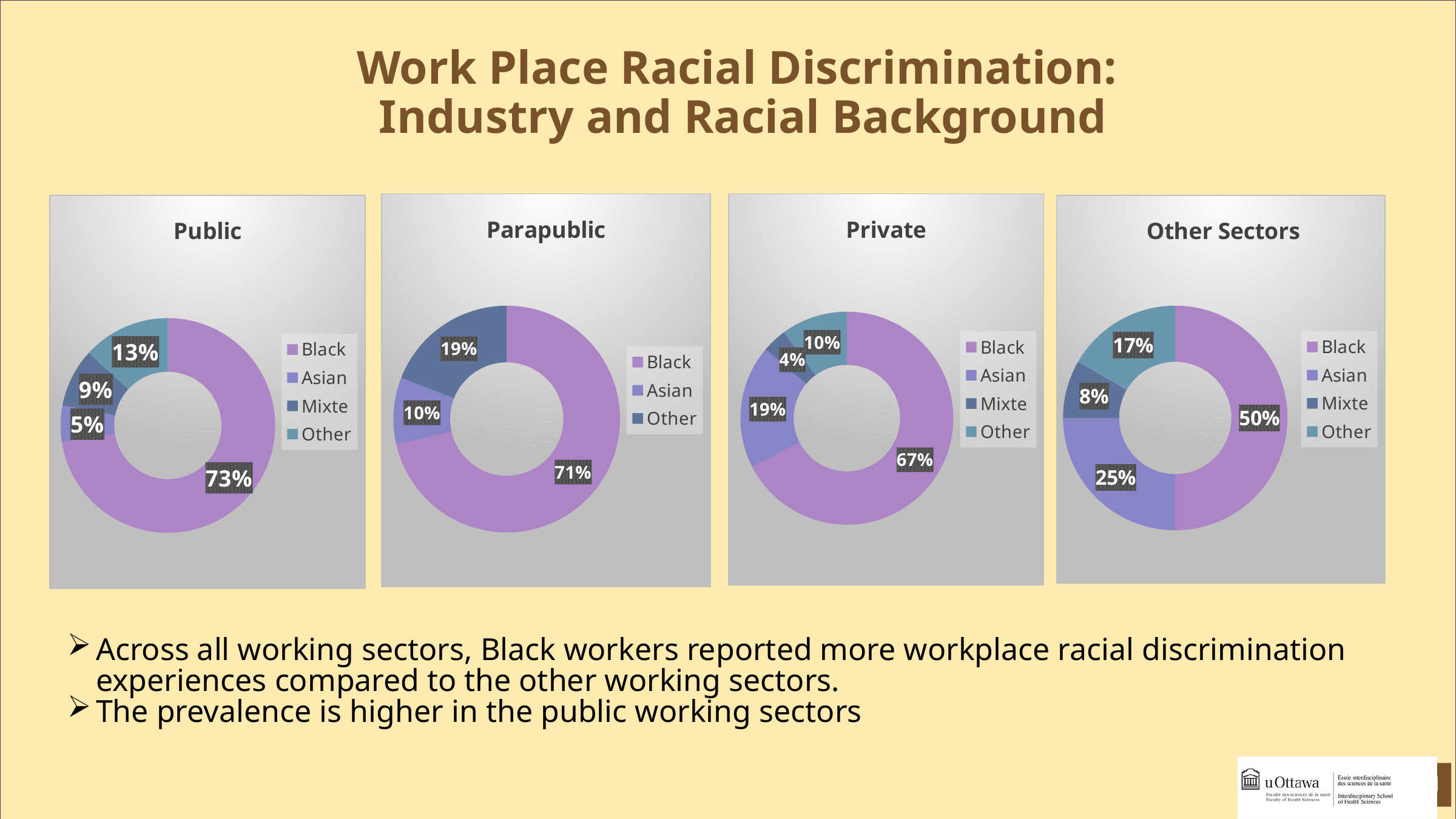
In the Parapublic chart, what percentage is shown for Other? 19% In the Private chart, what percentage is shown for Mixte? 4% In the Other Sectors chart, what percentage is shown for Asian? 25% How many slices does the Private chart have? 4 In the Public chart, which is larger, the share for Mixte or the share for Other? Other In the Other Sectors chart, what is the difference between the Black share and the Asian share? 25% What kind of chart is the Other Sectors chart? Donut (pie) chart In the Private chart, which category has the largest share? Black In the Public chart, which category has the smallest share? Asian How many series does the legend of the Parapublic chart list? 3 How many charts are shown on the slide? 4 In the Public chart, what percentage is shown for Black? 73%